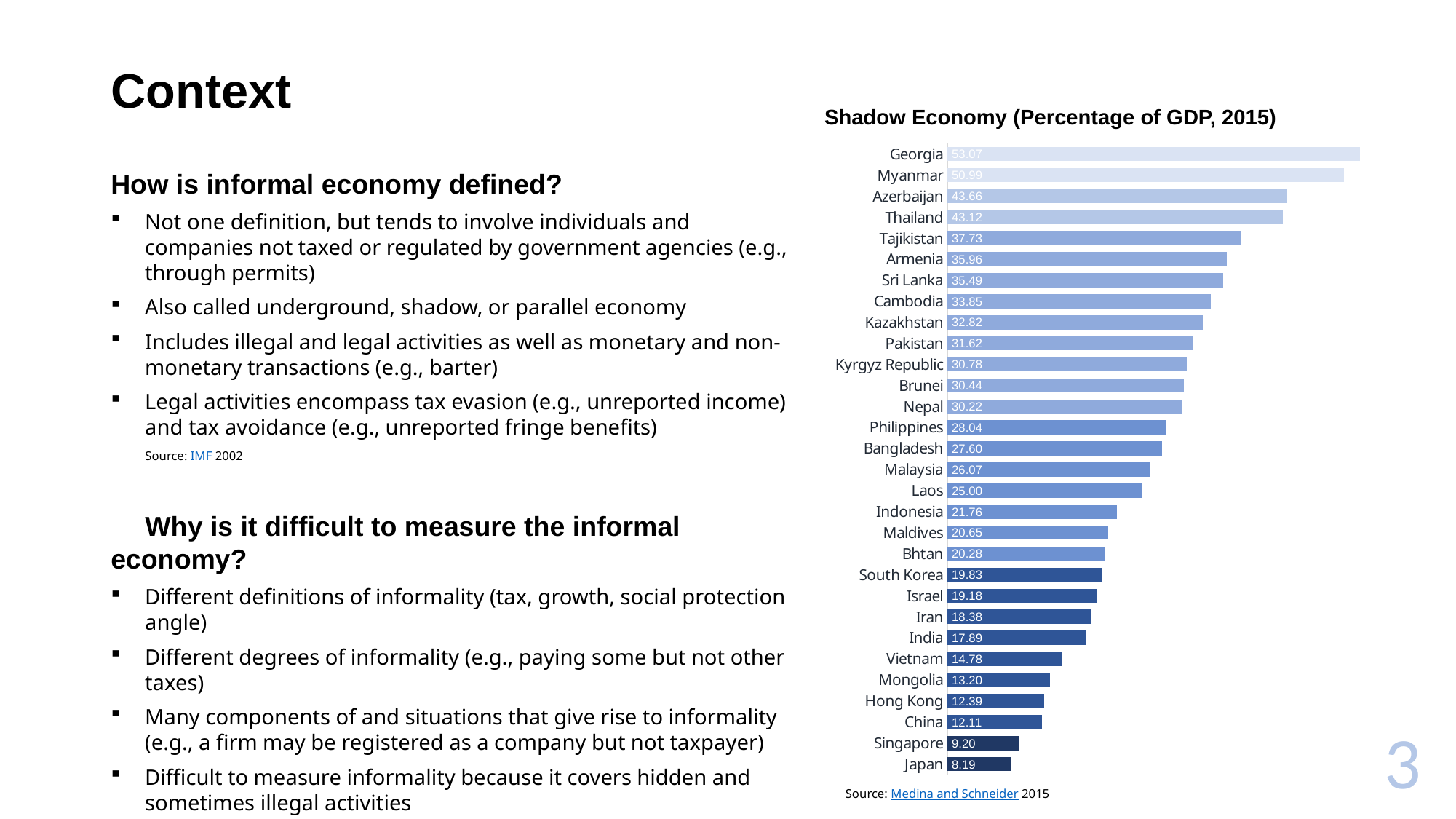
Which country has the highest shadow economy percentage of GDP? Georgia Which country has the lowest shadow economy percentage of GDP? Japan What is the difference between the values for Georgia and Myanmar? 2.08 What is the shadow economy value for Kyrgyz Republic? 30.78 What is the title of the chart? Shadow Economy (Percentage of GDP, 2015) How many countries are shown in the chart? 30 What is the shadow economy value for Thailand? 43.12 What is the difference between the values for Georgia and Japan? 44.88 What is the shadow economy value for Vietnam? 14.78 Which has a larger shadow economy value, Singapore or Hong Kong? Hong Kong What kind of chart is used to show the shadow economy data? Bar chart Which has a larger shadow economy value, Indonesia or Malaysia? Malaysia